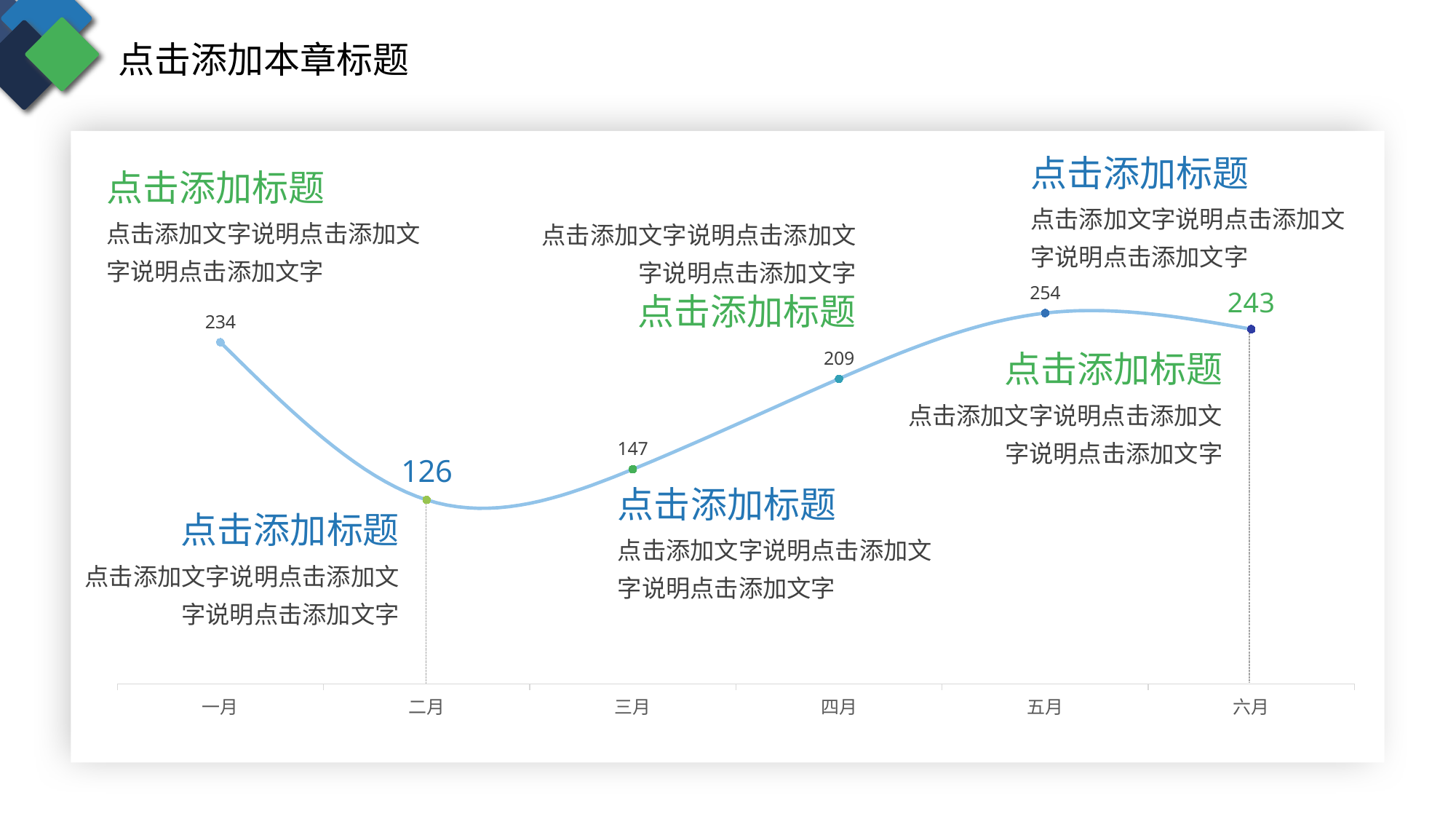
Which month has the highest value? 五月 How many months are plotted on the x axis? 6 What is the difference between the values for 五月 and 六月? 11 Which is larger, the value for 三月 or the value for 四月? 四月 What is the value for 一月? 234 What is the value for 六月? 243 What is the difference between the values for 一月 and 二月? 108 What is the value for 二月? 126 Do the values rise or fall from 二月 to 五月? rise What kind of chart is shown on the slide? line chart Which month has the lowest value? 二月 What is the value for 四月? 209